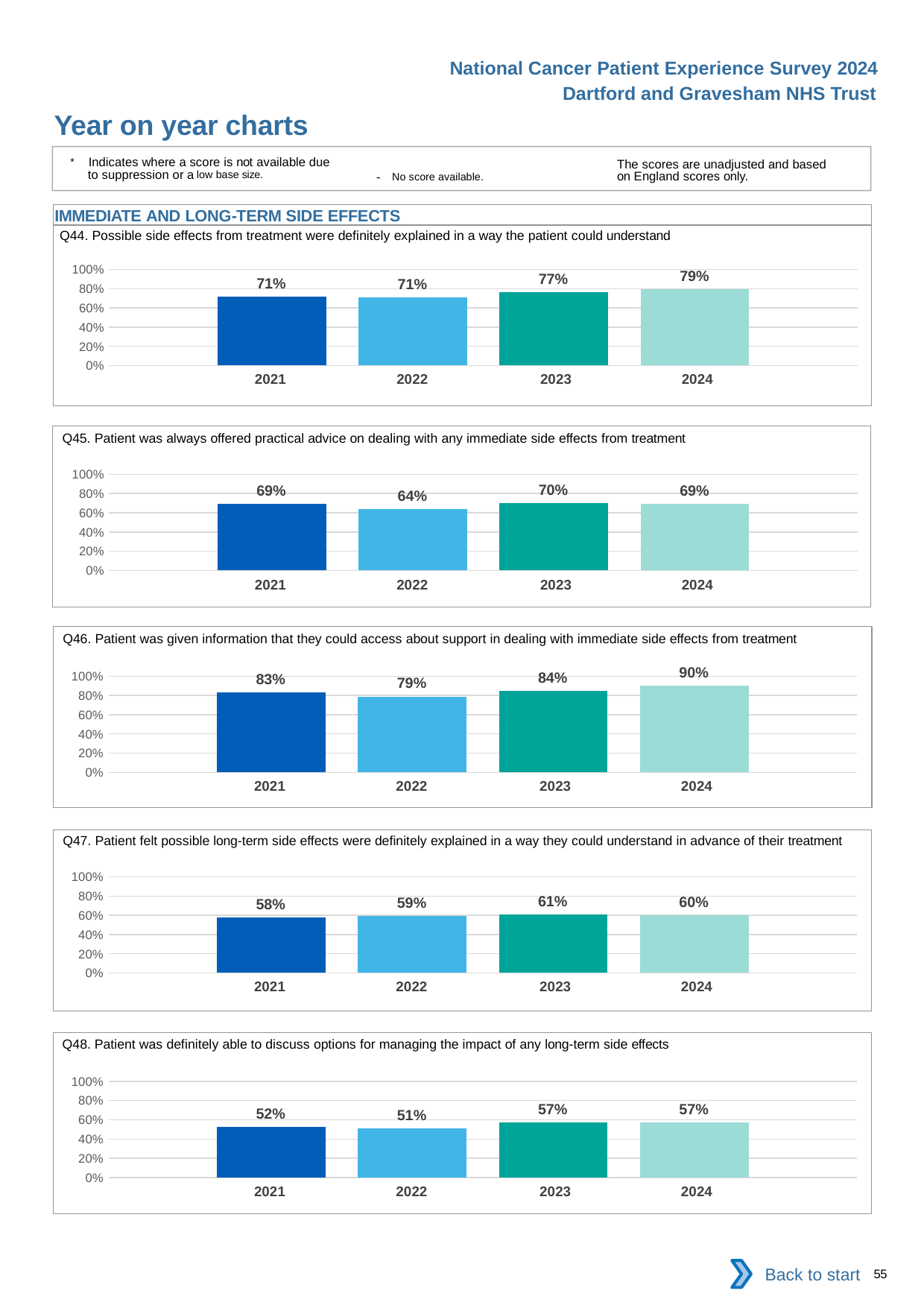
In the Q48 chart, what is the value for 2021? 52% In the Q47 chart, which year has the highest value? 2023 In the Q44 chart, what is the value for 2024? 79% How many charts are shown on the slide? 5 What kind of chart is the Q48 chart? Bar chart In the Q45 chart, which year has the lowest value? 2022 In the Q46 chart, is the value for 2024 greater or less than 80%? greater In the Q47 chart, what is the difference between the 2023 and 2021 values? 3% In the Q44 chart, do the values rise or fall from 2022 to 2024? Rise How many years are shown in the Q45 chart? 4 In the Q44 chart, is the value for 2023 larger than the value for 2022? Yes In the Q46 chart, what is the difference between the 2024 and 2022 values? 11%